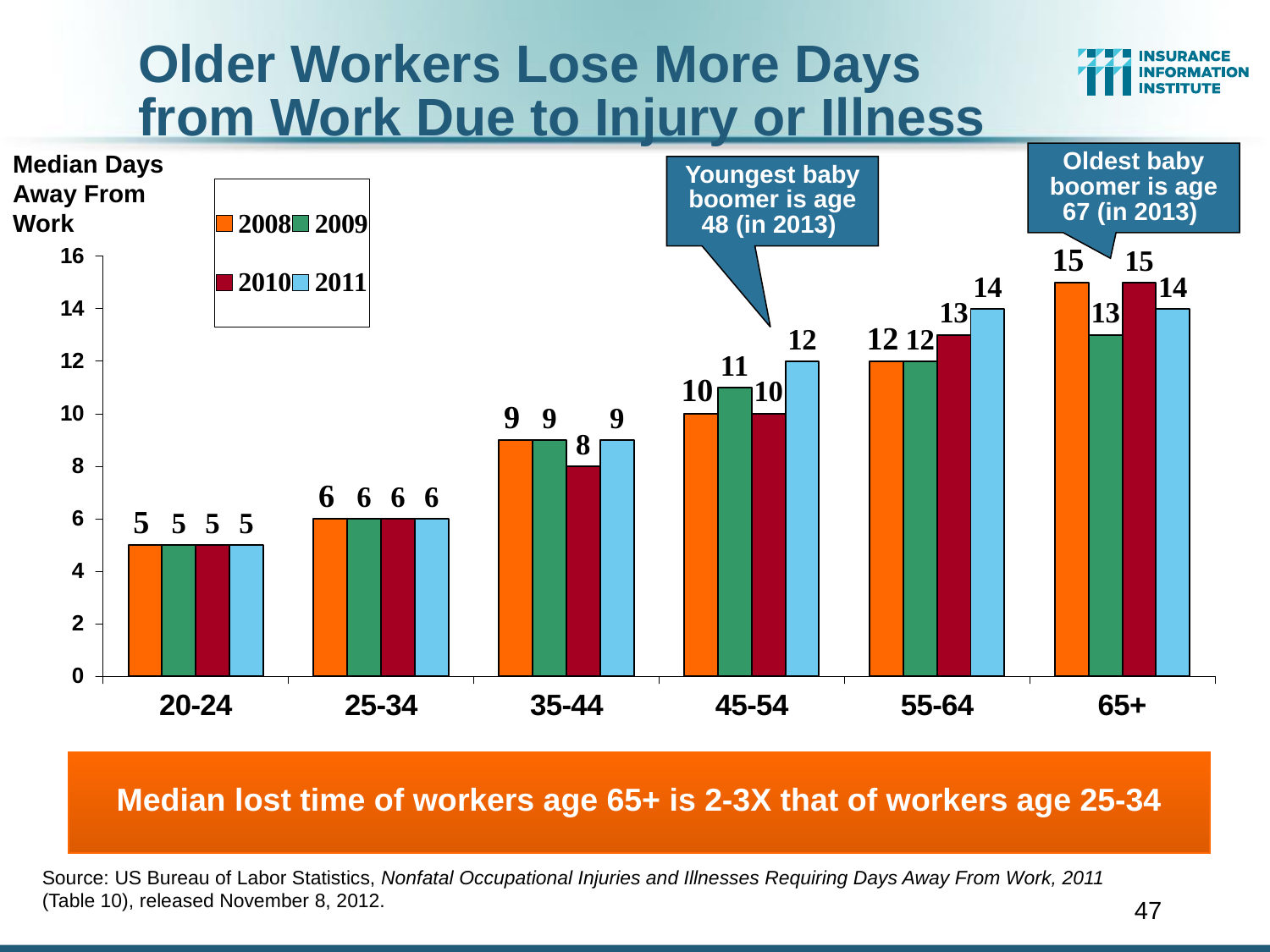
Which years are listed in the chart legend? 2008, 2009, 2010, 2011 Which age group has the lowest median days away from work in 2011? 20-24 How many series does the legend list? 4 Do the 2011 values rise or fall as age group increases along the x axis? Rise What is the median days away from work for the 45-54 age group in 2011? 12 What is the median days away from work for the 35-44 age group in 2010? 8 How many age groups are shown on the x axis? 6 Which age group has the highest median days away from work in 2008? 65+ What is the median days away from work for the 65+ age group in 2009? 13 What kind of chart is shown on the slide? Bar chart What is the difference in median days away from work between the 65+ and 25-34 age groups in 2010? 9 Which is larger, the 2011 value for 55-64 or the 2011 value for 45-54? 55-64